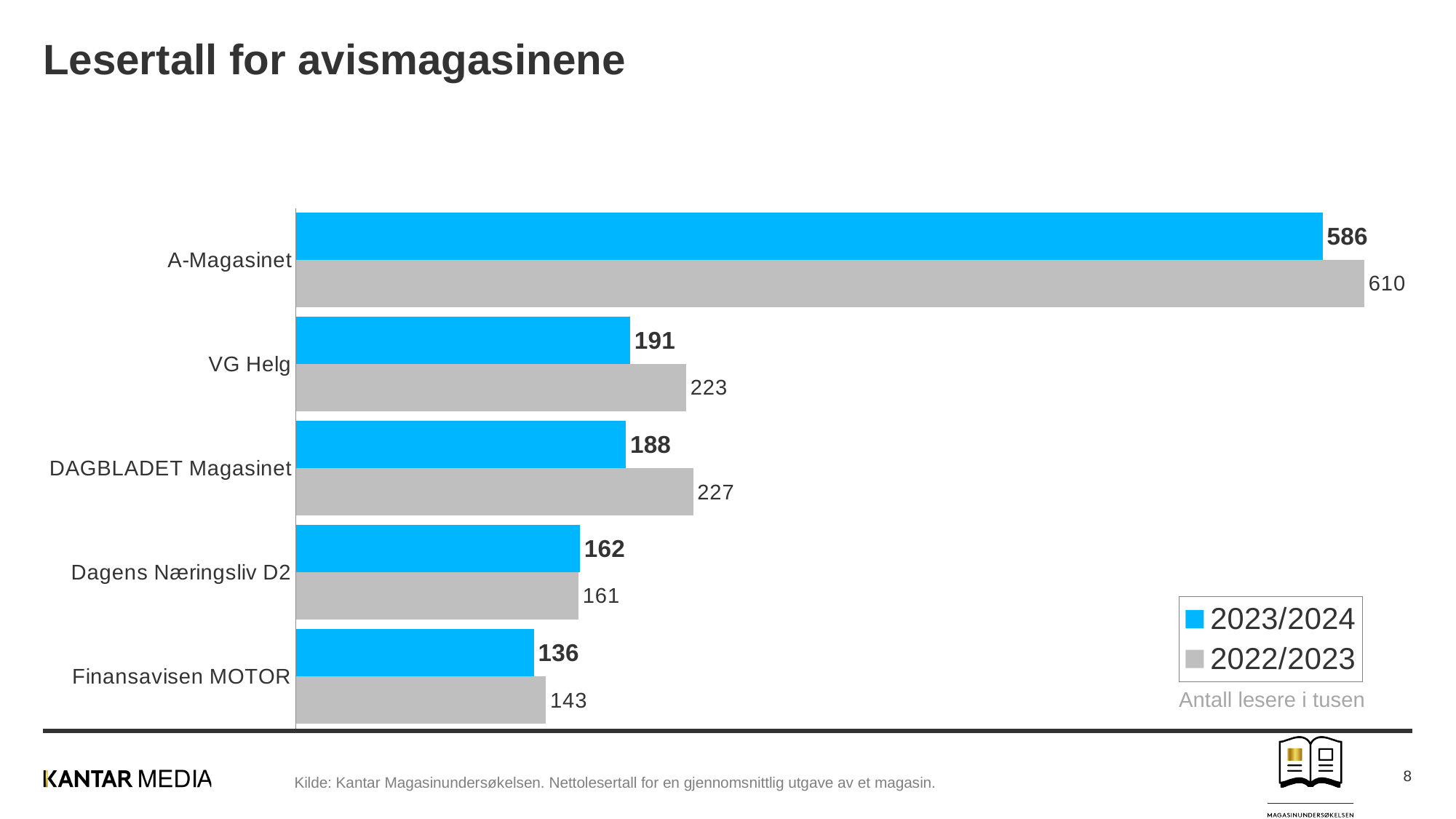
What is the difference between the 2022/2023 and 2023/2024 values for DAGBLADET Magasinet? 39 Which magazine has the lowest 2022/2023 reader figure? Finansavisen MOTOR Which is larger for Dagens Næringsliv D2: the 2023/2024 value or the 2022/2023 value? 2023/2024 What is the 2023/2024 value for Finansavisen MOTOR? 136 What is the 2023/2024 value for A-Magasinet? 586 What is the 2022/2023 value for VG Helg? 223 How many magazines are shown in the chart? 5 What is the title of the chart? Lesertall for avismagasinene How many series does the legend list? 2 What kind of chart is shown on the slide? Bar chart Which magazine has the highest 2023/2024 reader figure? A-Magasinet What is the difference between the 2022/2023 and 2023/2024 values for A-Magasinet? 24